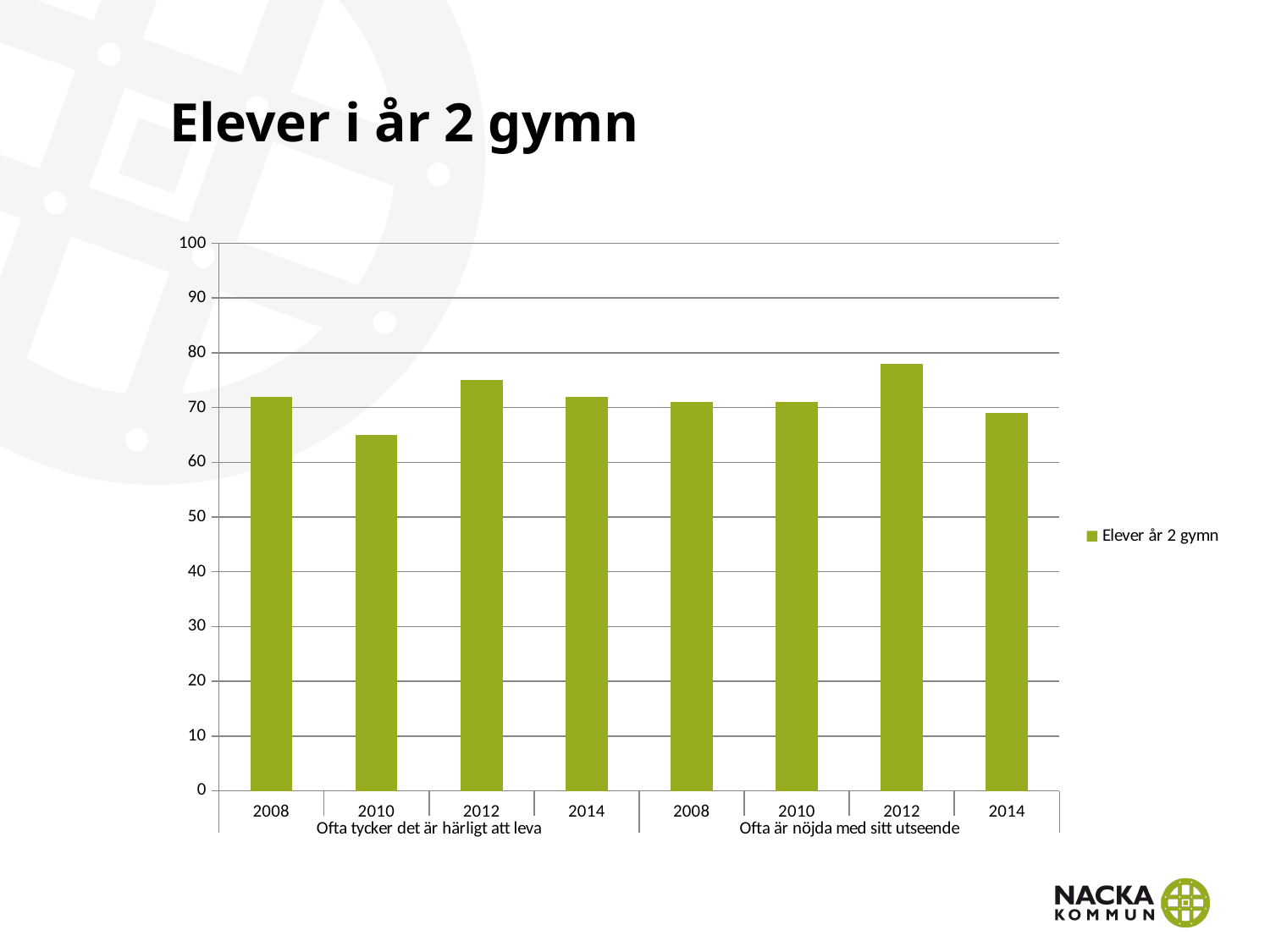
How many series does the legend list? 1 Which bar is the highest in the chart? 2012 under Ofta är nöjda med sitt utseende Under 'Ofta tycker det är härligt att leva', does the value rise or fall from 2008 to 2010? fall What is the title of the slide containing the chart? Elever i år 2 gymn Which bar is the lowest in the chart? 2010 under Ofta tycker det är härligt att leva Is the value for 2014 under 'Ofta är nöjda med sitt utseende' greater or less than 80? less Is the value for 2010 under 'Ofta tycker det är härligt att leva' greater or less than 70? less Is the value for 2012 under 'Ofta är nöjda med sitt utseende' greater or less than 70? greater How many bars are plotted in the chart? 8 What kind of chart is shown on the slide? bar chart Which is larger: the 2010 bar under 'Ofta tycker det är härligt att leva' or the 2012 bar under 'Ofta är nöjda med sitt utseende'? 2012 under Ofta är nöjda med sitt utseende What is the legend entry for the series in the chart? Elever år 2 gymn